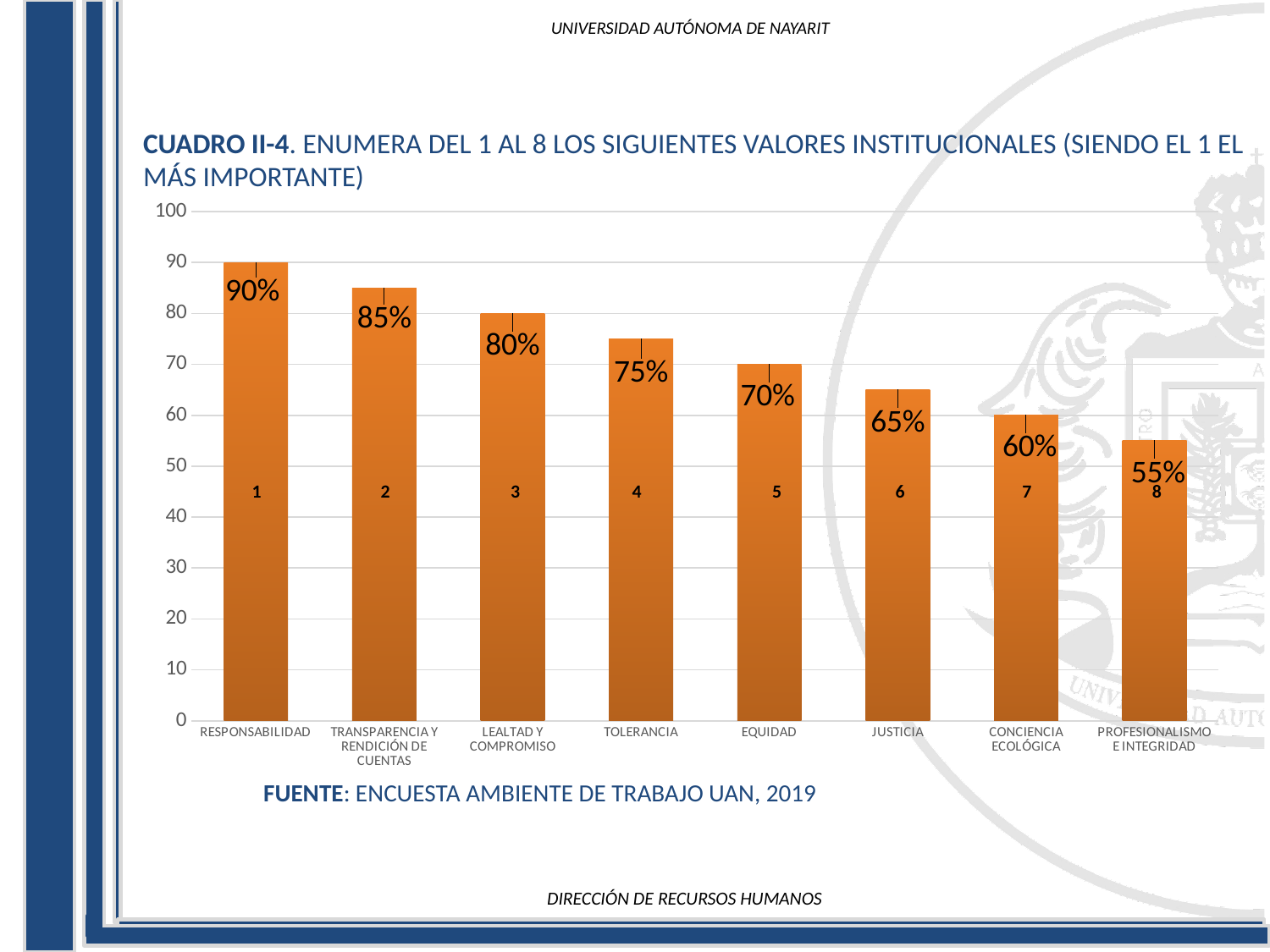
What is the value for TOLERANCIA? 75% What is the value for CONCIENCIA ECOLÓGICA? 60% How many categories are shown on the x axis? 8 Is the value for LEALTAD Y COMPROMISO greater or less than 70? greater Which category has the highest value? RESPONSABILIDAD Which is larger, the value for EQUIDAD or the value for JUSTICIA? EQUIDAD What source is cited below the chart? ENCUESTA AMBIENTE DE TRABAJO UAN, 2019 What kind of chart is this? bar chart Which category has the lowest value? PROFESIONALISMO E INTEGRIDAD Do the values rise or fall from left to right along the x axis? fall What is the value for RESPONSABILIDAD? 90% What is the difference between the values for RESPONSABILIDAD and PROFESIONALISMO E INTEGRIDAD? 35%